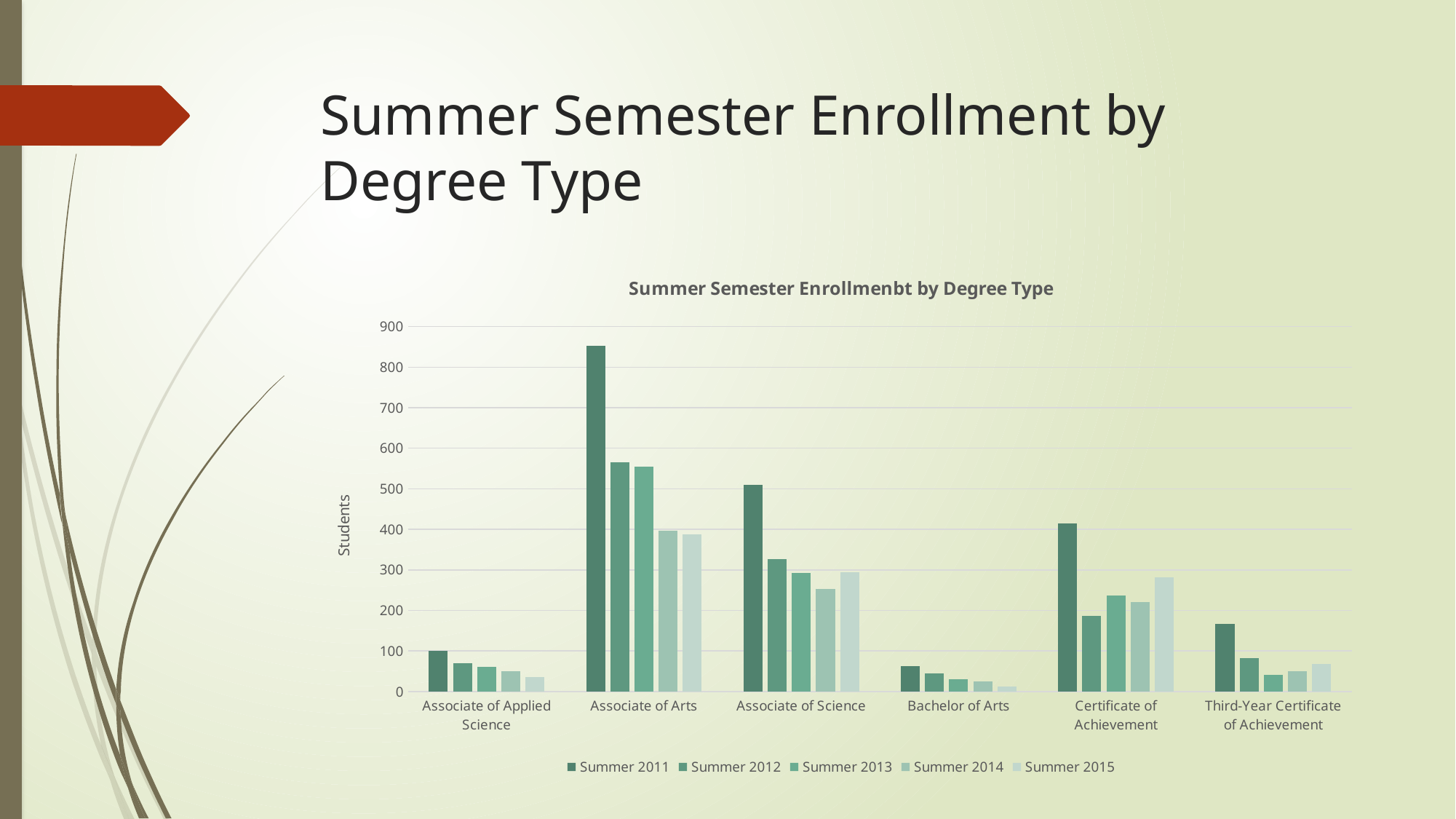
Which is larger for Summer 2012: Associate of Arts or Associate of Science? Associate of Arts Is the Summer 2011 value for Associate of Arts greater or less than 800? greater Is the Summer 2011 value for Associate of Science greater or less than 400? greater What is the label on the vertical axis? Students Which degree type has the highest Summer 2011 enrollment? Associate of Arts For Certificate of Achievement, which is larger: Summer 2012 or Summer 2015? Summer 2015 Which degree type has the lowest Summer 2015 enrollment? Bachelor of Arts Is the Summer 2011 value for Bachelor of Arts greater or less than 100? less How many degree type categories are shown on the x axis? 6 How many series does the legend list? 5 What kind of chart is shown on the slide? bar chart Do the Associate of Applied Science values rise or fall from Summer 2011 to Summer 2015? fall